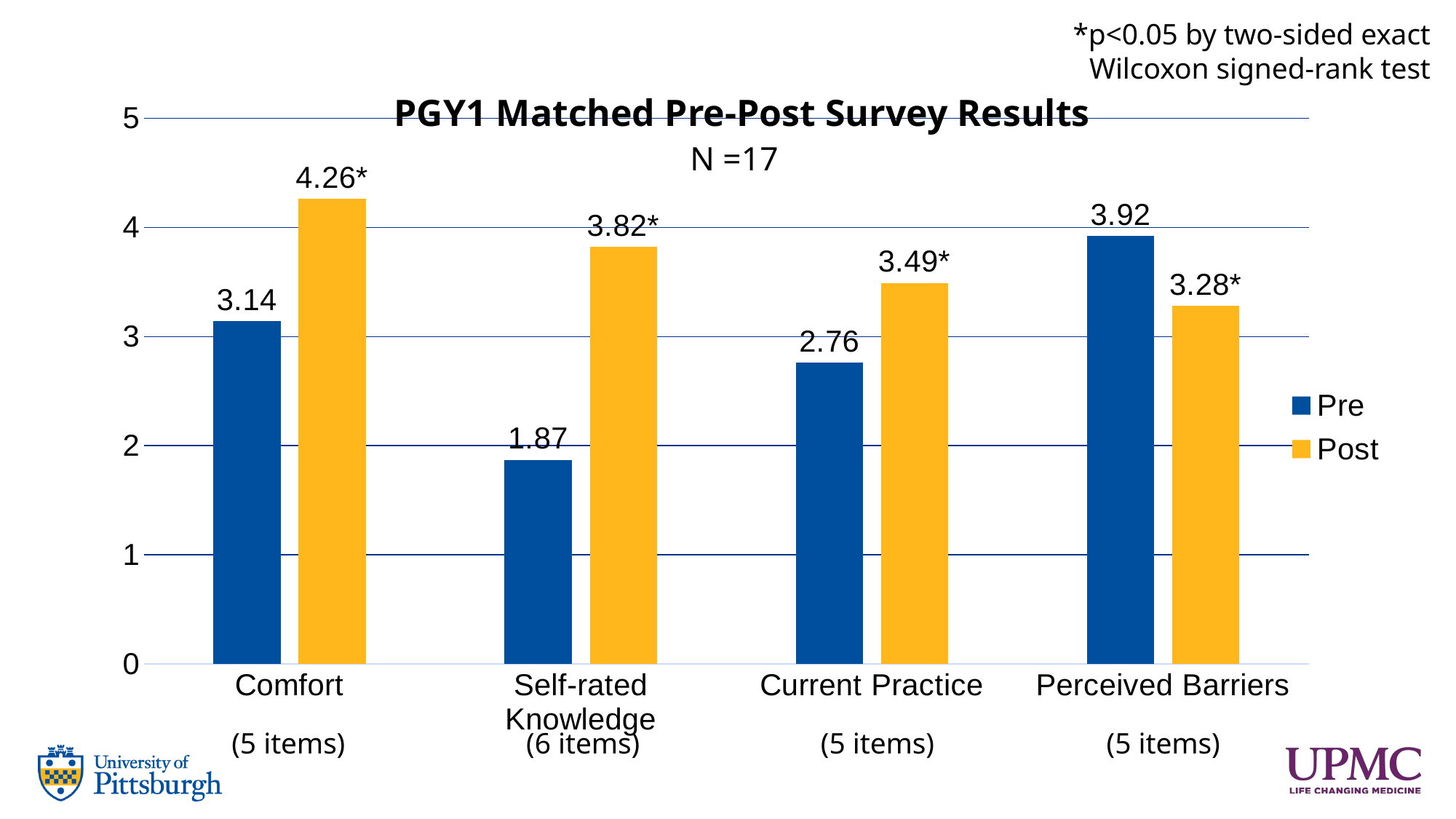
Which category has the highest Post value? Comfort How many series does the legend list? 2 For Perceived Barriers, which is larger, the Pre value or the Post value? Pre What is the Post value for Current Practice? 3.49* Which category has the lowest Pre value? Self-rated Knowledge What is the Post value for Comfort? 4.26* What kind of chart is shown on the slide? Bar chart What is the Pre value for Perceived Barriers? 3.92 What is the title of the chart? PGY1 Matched Pre-Post Survey Results What is the difference between the Post and Pre values for Self-rated Knowledge? 1.95 What is the Pre value for Self-rated Knowledge? 1.87 How many categories are shown on the x axis? 4